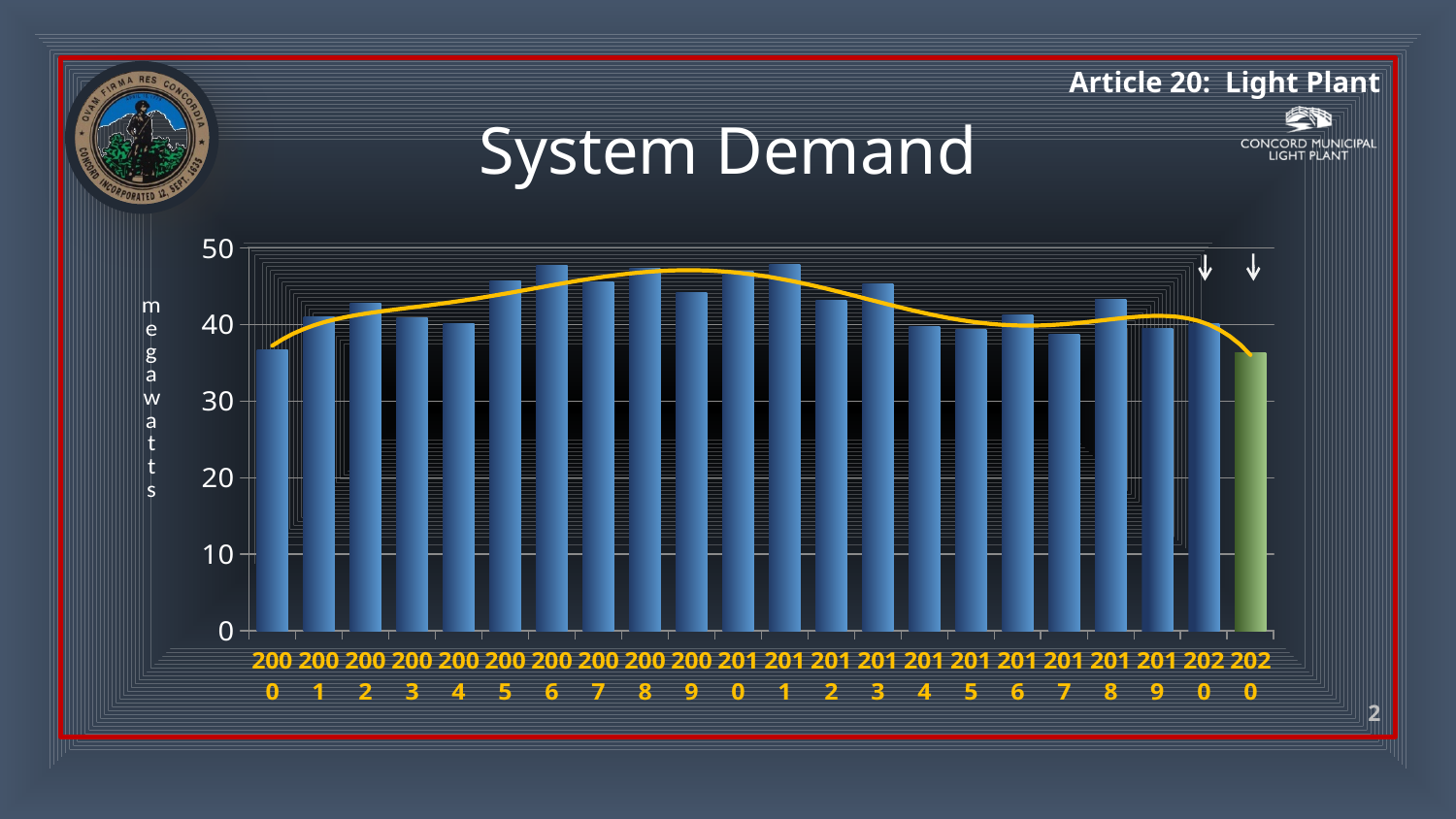
Do the values generally rise or fall from 2010 to 2016? fall Is the value for 2000 greater or less than 40? less Is the value for the final (green) 2020 bar greater or less than 40? less Which is larger, the value for 2006 or the value for 2000? 2006 Is the value for 2009 greater or less than 40? greater Which is larger, the value for 2005 or the value for 2004? 2005 How many bars are plotted in the chart? 22 What is the title of the chart? System Demand What unit is shown on the vertical axis label of the chart? megawatts What type of chart is shown on the slide? bar chart